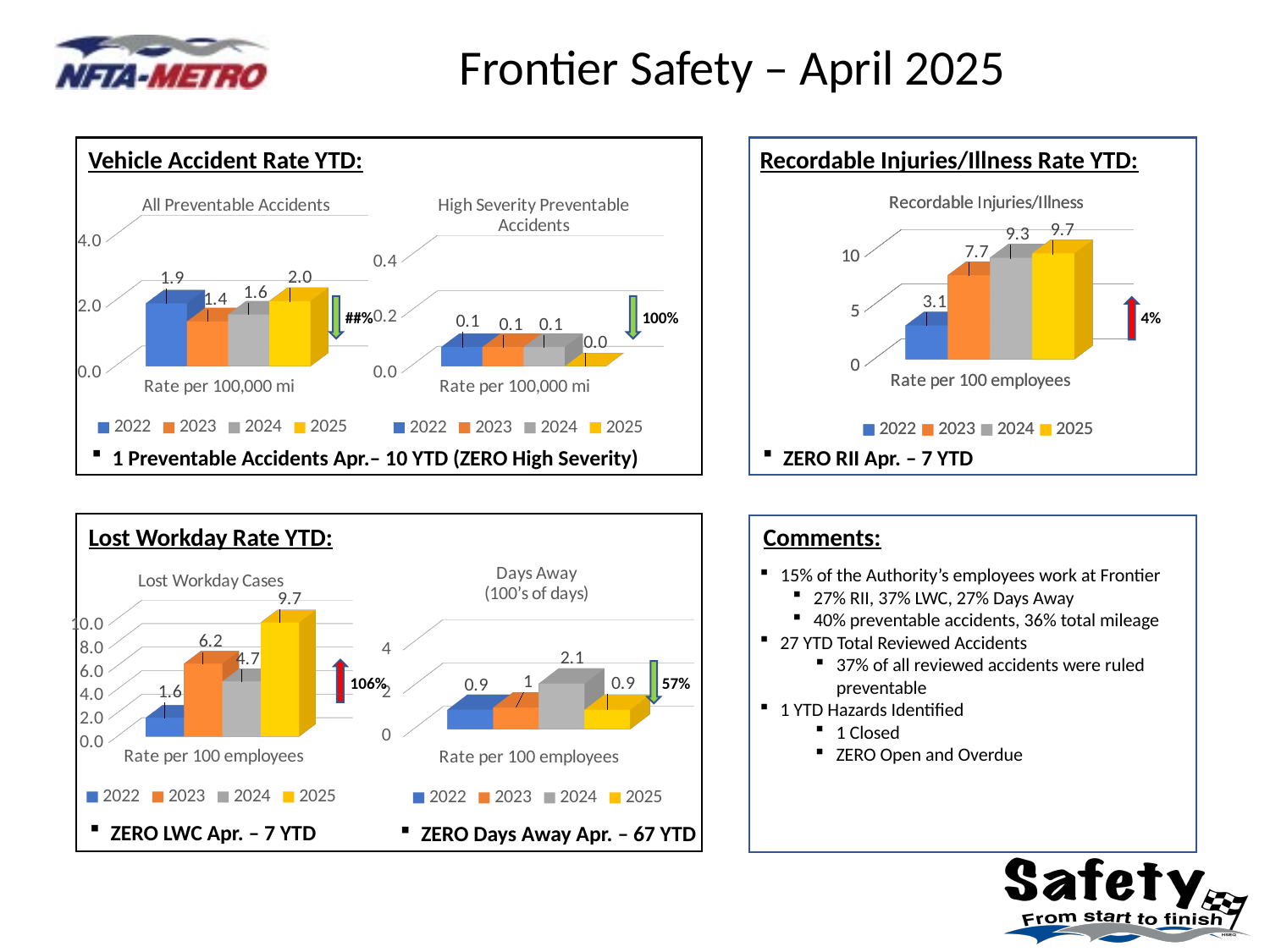
In the "Recordable Injuries/Illness" chart, which year has the highest value? 2025 In the "Lost Workday Cases" chart, which is larger, the 2023 value or the 2024 value? 2023 In the "Recordable Injuries/Illness" chart, what is the difference between the 2025 and 2024 values? 0.4 In the "Recordable Injuries/Illness" chart, what is the value for 2022? 3.1 In the "All Preventable Accidents" chart, what is the value for 2025? 2.0 In the "High Severity Preventable Accidents" chart, what is the value for 2025? 0.0 What kind of chart is the "Recordable Injuries/Illness" chart? bar chart In the "Recordable Injuries/Illness" chart, do the values rise or fall from 2022 to 2025? rise In the "Days Away (100's of days)" chart, what is the value for 2024? 2.1 How many series does the legend of the "Lost Workday Cases" chart list? 4 In the "All Preventable Accidents" chart, which year has the lowest value? 2023 In the "Lost Workday Cases" chart, what is the value for 2025? 9.7